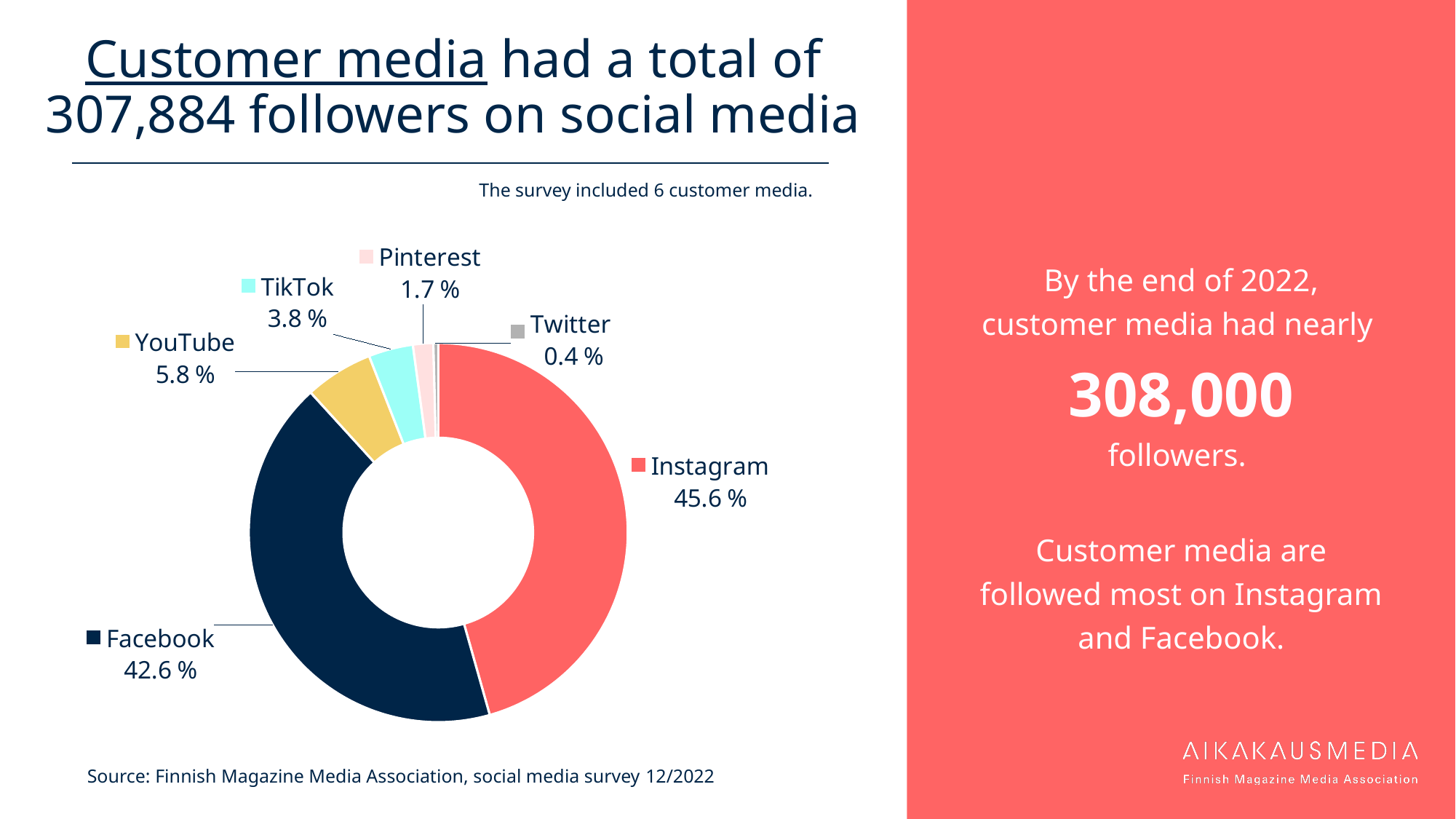
What share of customer media social media followers is on Instagram? 45.6 % How many percentage points larger is Instagram's share than Facebook's? 3 percentage points What percentage of followers is on Pinterest? 1.7 % What percentage of followers is on YouTube? 5.8 % What share of followers is on TikTok? 3.8 % What share of followers does Facebook account for? 42.6 % What is the combined share of Instagram and Facebook? 88.2 % Which platform has the largest share of followers? Instagram How many platforms are shown in the chart? 6 What type of chart is used on the slide? Doughnut (pie) chart Which has a larger share of followers, YouTube or TikTok? YouTube Which platform has the smallest share of followers? Twitter